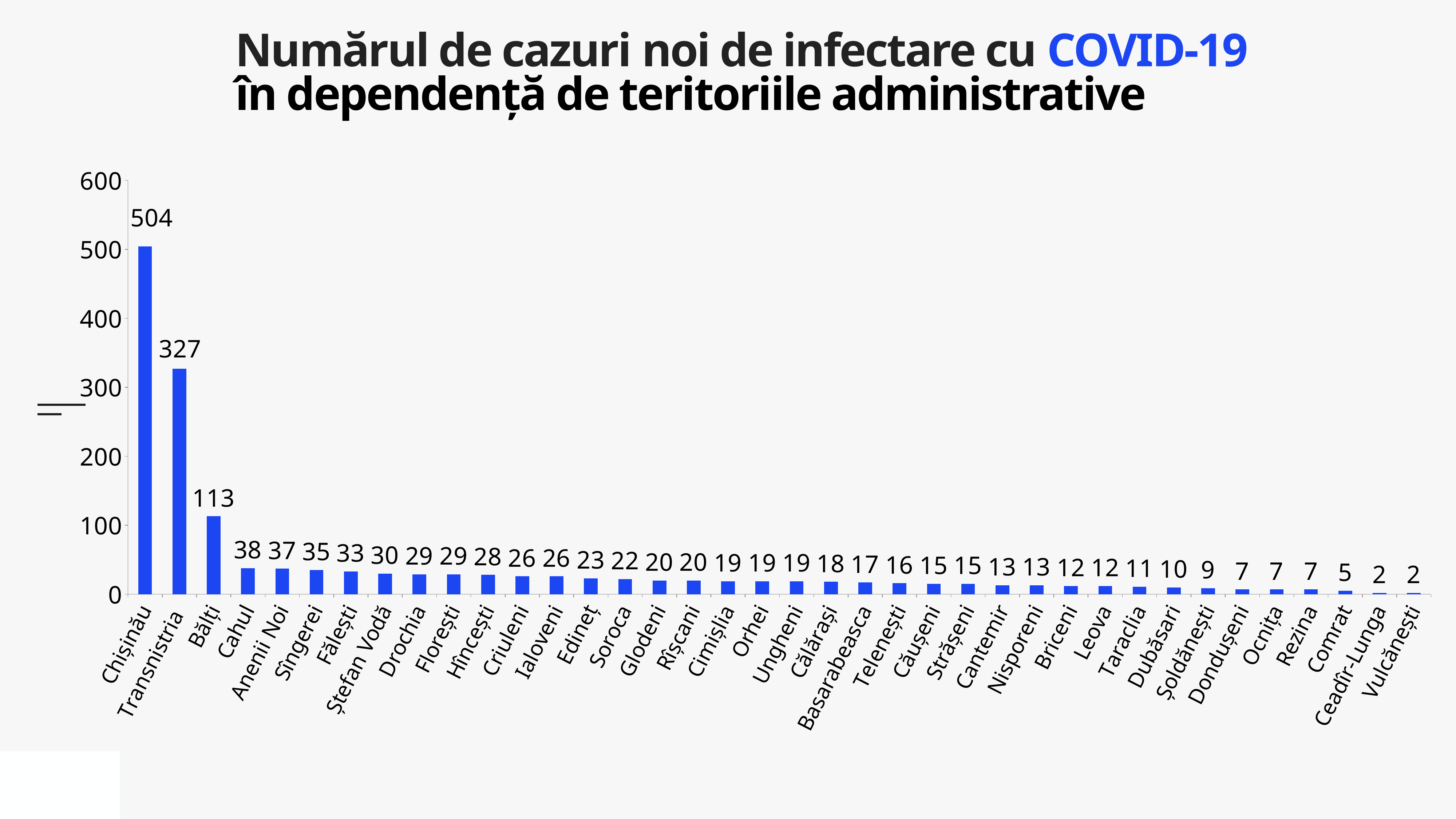
What type of chart is shown on the slide? Bar chart Is the value for Transnistria greater or less than 300? greater What is the number of new COVID-19 cases for Chișinău? 504 What is the value shown for Bălți? 113 What is the value shown for Comrat? 5 What is the difference between the values for Bălți and Cahul? 75 What is the difference between the values for Chișinău and Transnistria? 177 Which administrative territory has the highest number of new cases? Chișinău What is the value shown for Transnistria? 327 Which has a larger value, Soroca or Orhei? Soroca What is the value shown for Cahul? 38 How many administrative territories are shown on the chart? 38